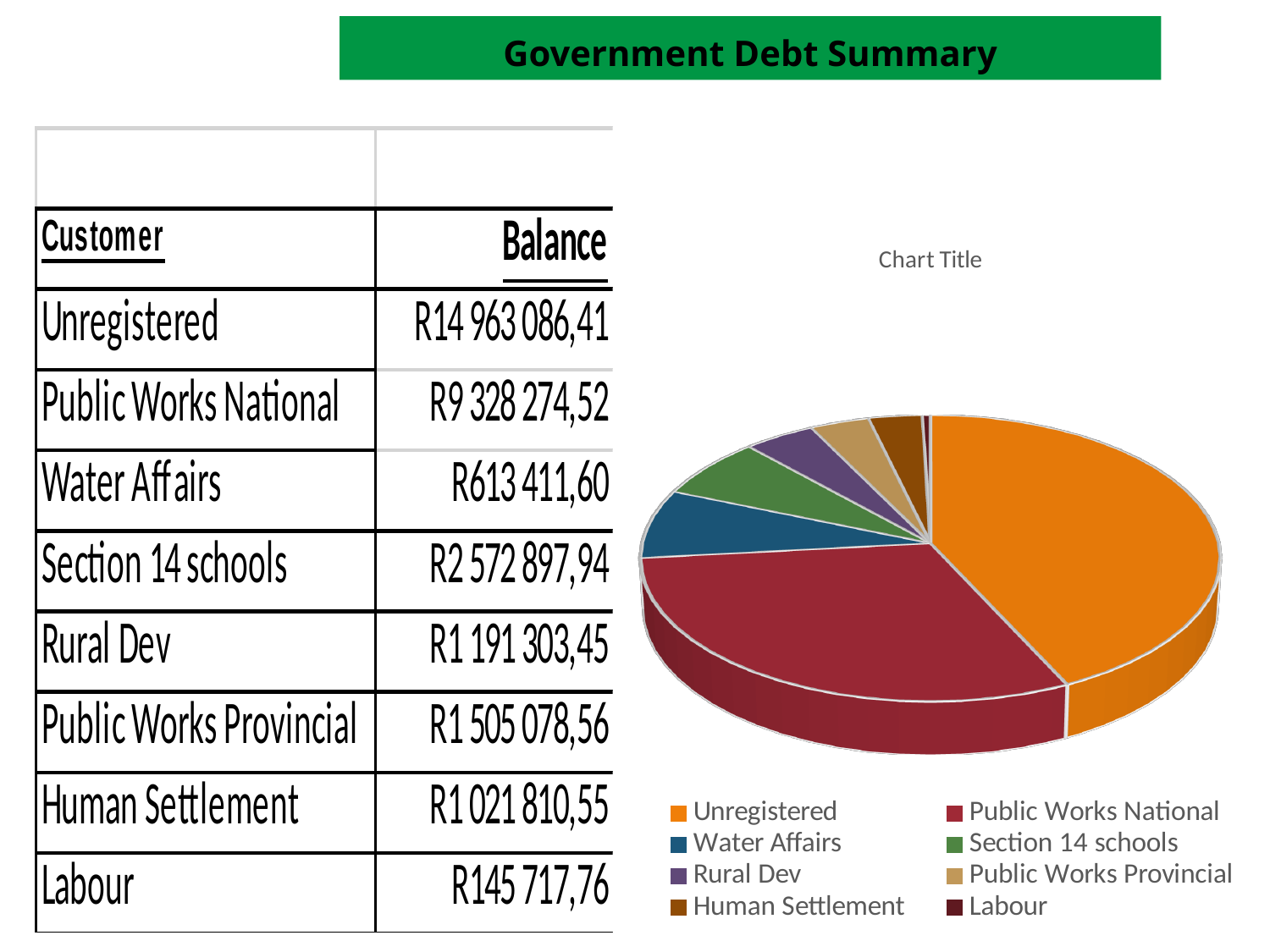
What is the balance for Unregistered? R14 963 086,41 What colour is the Unregistered slice in the pie chart? orange What is the balance for Section 14 schools? R2 572 897,94 Which category has the smallest slice in the pie chart? Labour What is the balance for Public Works National? R9 328 274,52 Which is larger, the balance for Unregistered or for Public Works National? Unregistered What is the balance for Labour? R145 717,76 Which category has the largest slice in the pie chart? Unregistered How many categories does the pie chart's legend list? 8 Which is larger, the balance for Section 14 schools or for Water Affairs? Section 14 schools What type of chart is shown on the slide? pie chart What is the difference between the balances for Unregistered and Public Works National? R5 634 811,89